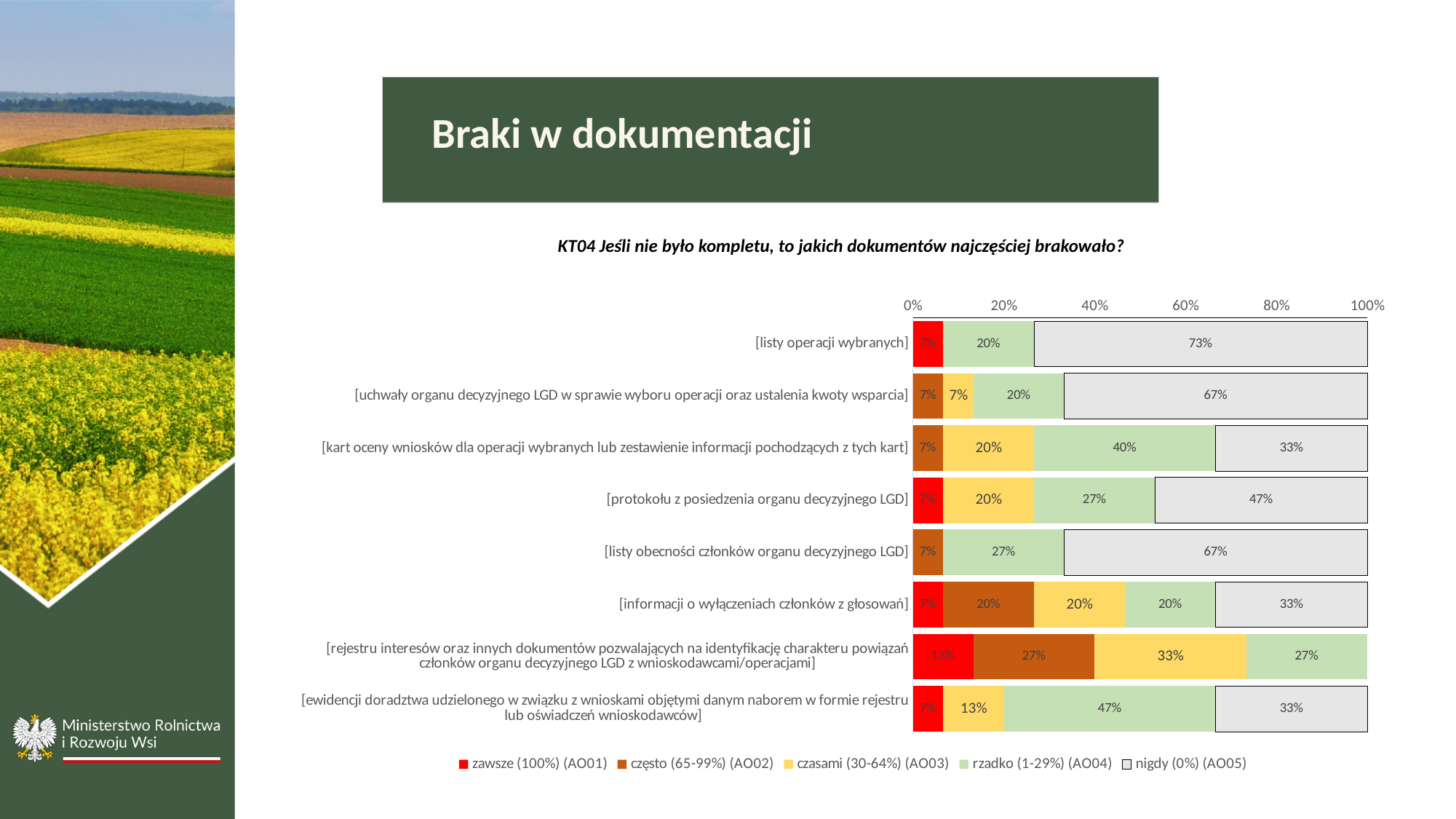
What type of chart is shown on the slide? Stacked bar chart What is the difference between the 'nigdy (0%) (AO05)' share for '[listy operacji wybranych]' and for '[kart oceny wniosków ...]'? 40 percentage points Which category has the highest 'nigdy (0%) (AO05)' share? [listy operacji wybranych] What percentage is shown for 'nigdy (0%) (AO05)' in the '[listy operacji wybranych]' bar? 73% What percentage is shown for 'rzadko (1-29%) (AO04)' in the '[kart oceny wniosków dla operacji wybranych lub zestawienie informacji pochodzących z tych kart]' bar? 40% Which category has the highest 'zawsze (100%) (AO01)' share? [rejestru interesów oraz innych dokumentów ...] How many series does the legend list? 5 What percentage is shown for 'czasami (30-64%) (AO03)' in the '[ewidencji doradztwa udzielonego ...]' bar? 13% Which has a larger 'rzadko (1-29%) (AO04)' share: '[ewidencji doradztwa udzielonego ...]' or '[protokołu z posiedzenia organu decyzyjnego LGD]'? [ewidencji doradztwa udzielonego ...] How many document categories are shown in the chart? 8 What percentage is shown for 'zawsze (100%) (AO01)' in the '[rejestru interesów ...]' bar? 13% What percentage is shown for 'często (65-99%) (AO02)' in the '[informacji o wyłączeniach członków z głosowań]' bar? 20%